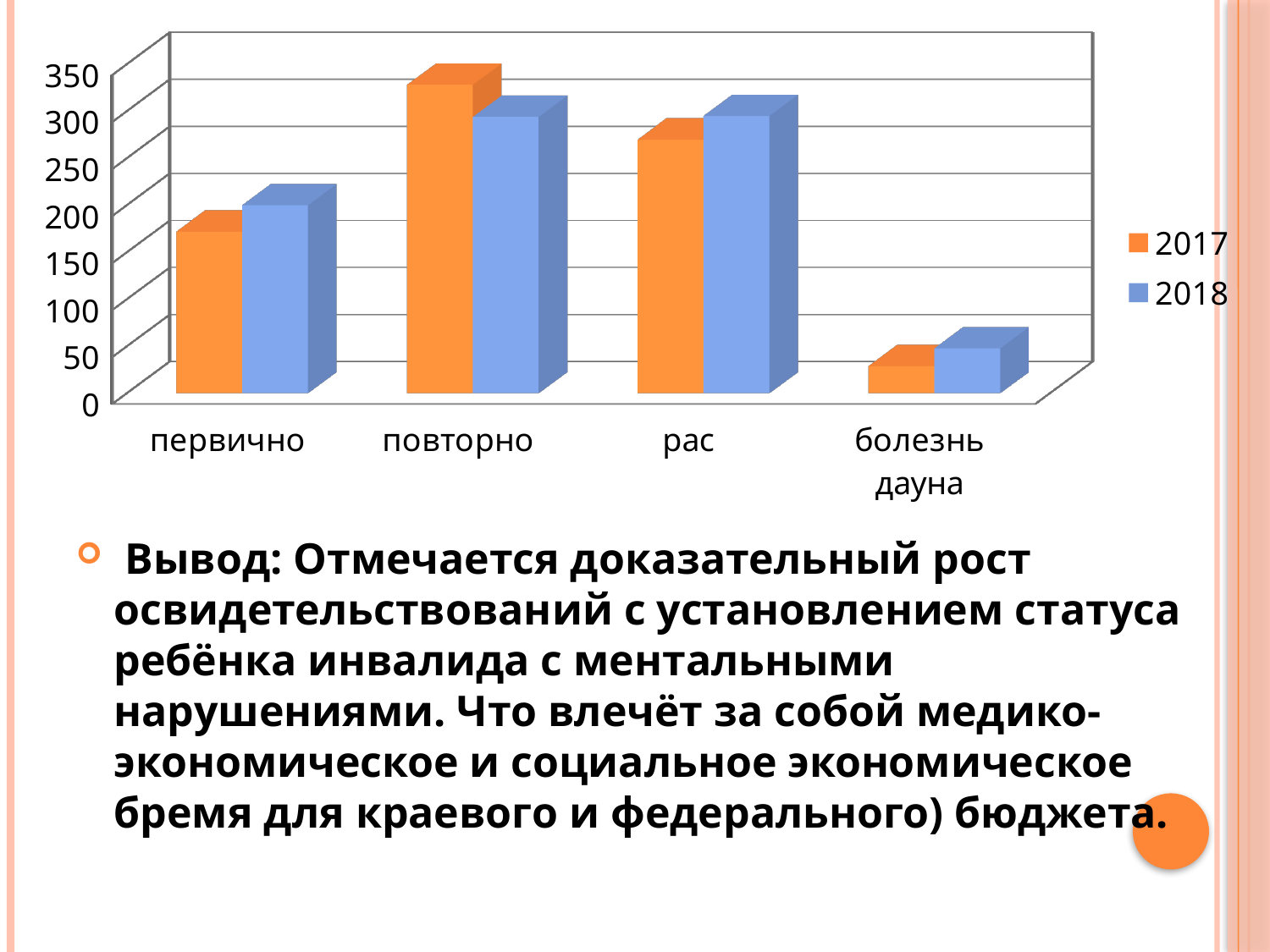
Which category has the lowest value for the 2018 series? болезнь дауна For the category первично, which series has the larger value, 2017 or 2018? 2018 For the category повторно, which series has the larger value, 2017 or 2018? 2017 Is the 2017 value for болезнь дауна greater or less than 100? less Which colour represents the 2017 series in the chart? orange How many series does the chart legend list? 2 What kind of chart is shown on the slide? bar chart Is the 2017 value for повторно greater or less than 300? greater Is the 2017 value for первично greater or less than 150? greater How many categories are shown on the x axis of the chart? 4 For the category рас, which series has the larger value, 2017 or 2018? 2018 Which category has the highest value for the 2017 series? повторно